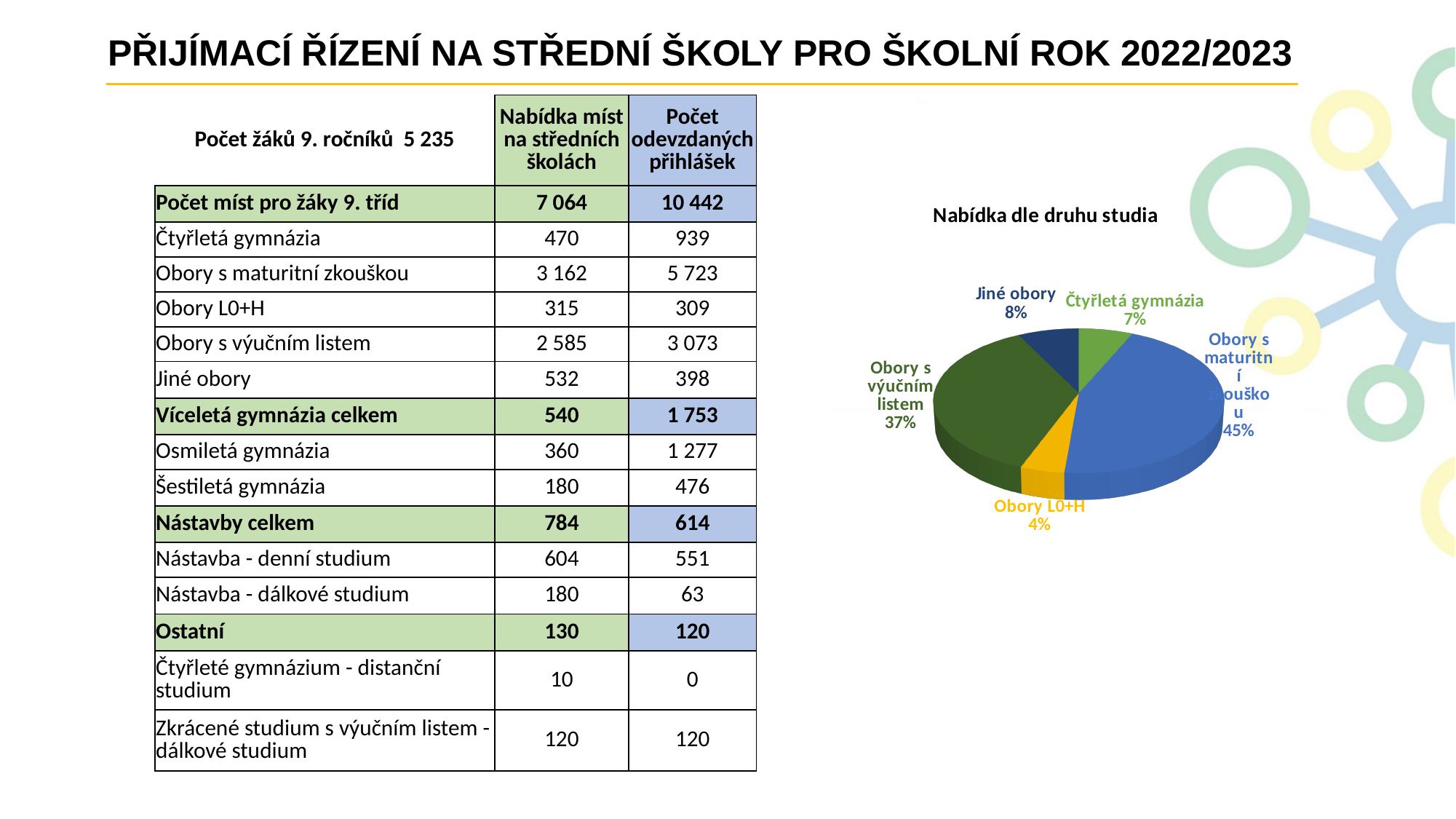
In the pie chart, which is larger: Jiné obory or Čtyřletá gymnázia? Jiné obory What share of the pie chart is Obory s výučním listem? 37% What kind of chart is shown on the slide? pie chart What share of the pie chart is Čtyřletá gymnázia? 7% What share of the pie chart is Obory s maturitní zkouškou? 45% In the pie chart, what is the difference in percentage points between Obory s maturitní zkouškou and Obory s výučním listem? 8 What is the title of the pie chart? Nabídka dle druhu studia How many slices does the pie chart have? 5 Which slice of the pie chart is the smallest? Obory L0+H Which slice of the pie chart is the largest? Obory s maturitní zkouškou